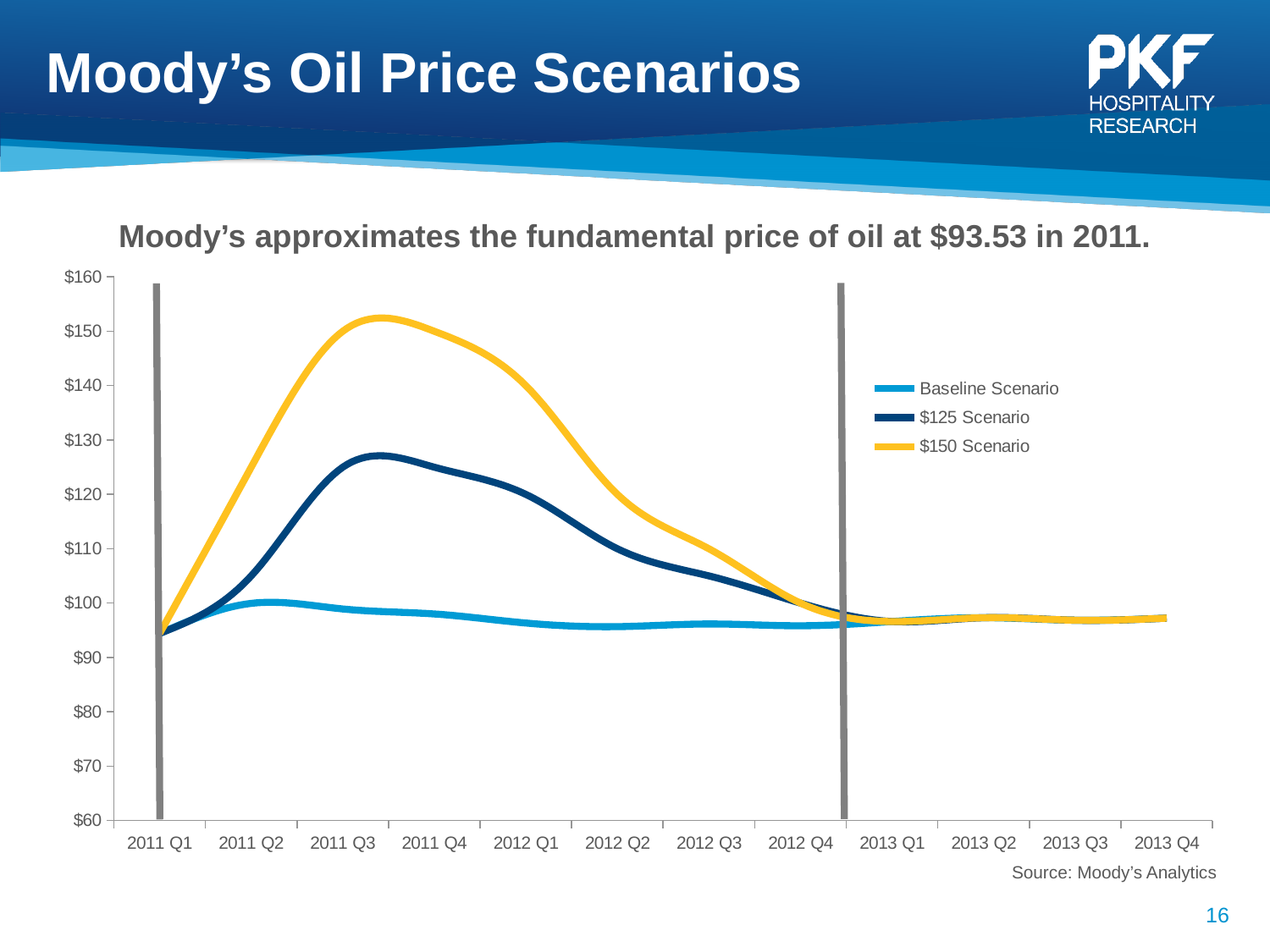
At 2011 Q4, which is higher, the $150 Scenario or the $125 Scenario? $150 Scenario Is the value for the Baseline Scenario at 2012 Q1 greater or less than $100? less Does the $150 Scenario rise or fall between 2011 Q3 and 2012 Q4? fall Is the value for the $150 Scenario at 2012 Q2 greater or less than $110? greater Which series is lowest at 2012 Q2? Baseline Scenario What source is cited below the chart? Moody's Analytics Is the value for the $125 Scenario at 2011 Q3 greater or less than $120? greater Which series reaches the highest value on the chart? $150 Scenario How many series does the legend list? 3 What kind of chart is shown on the slide? line chart How many quarters are labelled along the x axis? 12